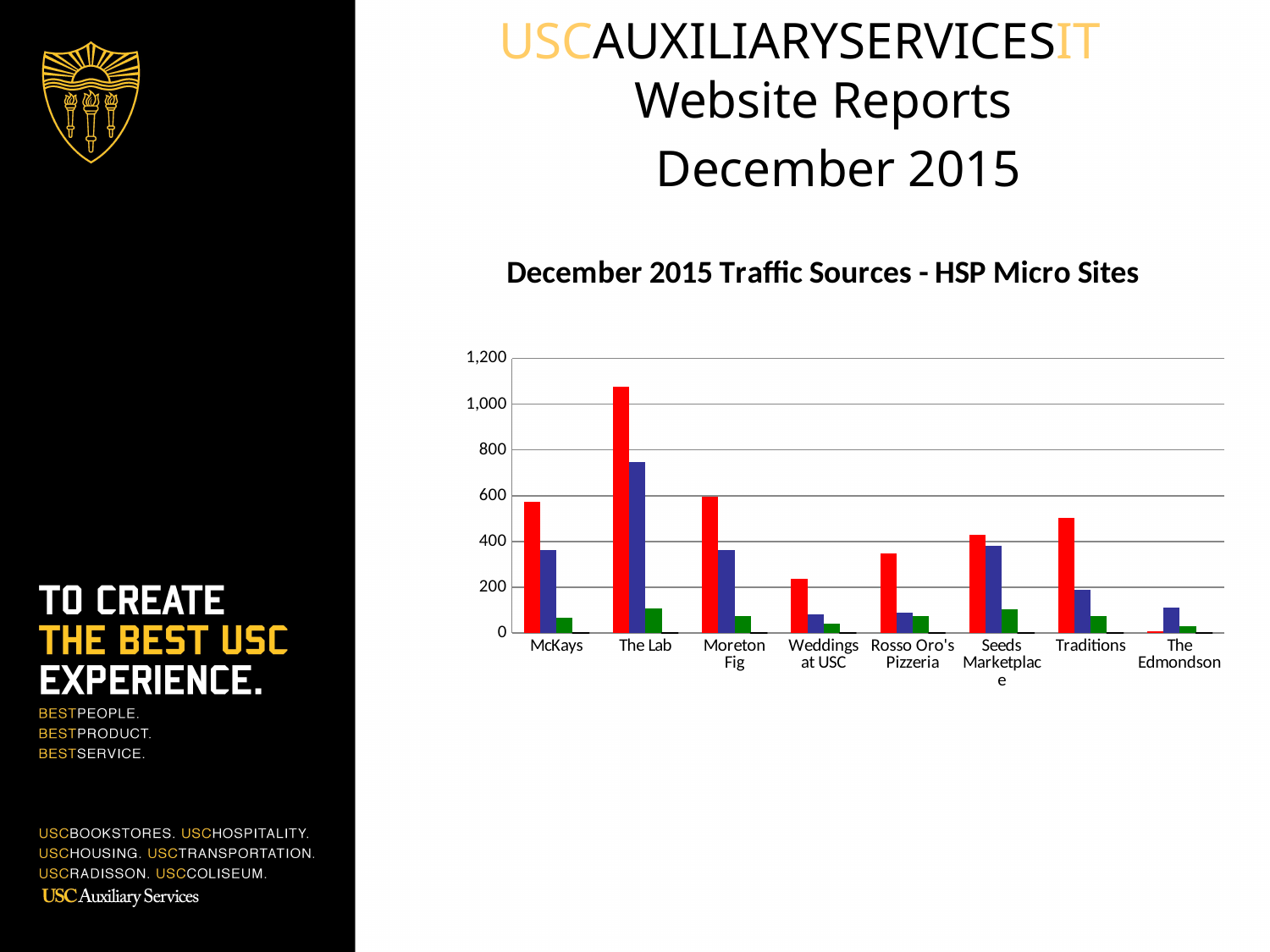
What is the highest value shown on the vertical axis? 1,200 Which micro site has the tallest blue bar? The Lab Which micro site has the tallest red bar? The Lab Is the red bar for McKays greater or less than 600? less What is the title of the chart? December 2015 Traffic Sources - HSP Micro Sites Which is larger, the red bar for Traditions or the red bar for Rosso Oro's Pizzeria? Traditions What kind of chart is shown on the slide? bar chart Is the red bar for Weddings at USC greater or less than 200? greater Is the red bar for The Lab greater or less than 1,000? greater How many micro sites (categories) are shown on the x axis? 8 Which micro site has the shortest red bar? The Edmondson